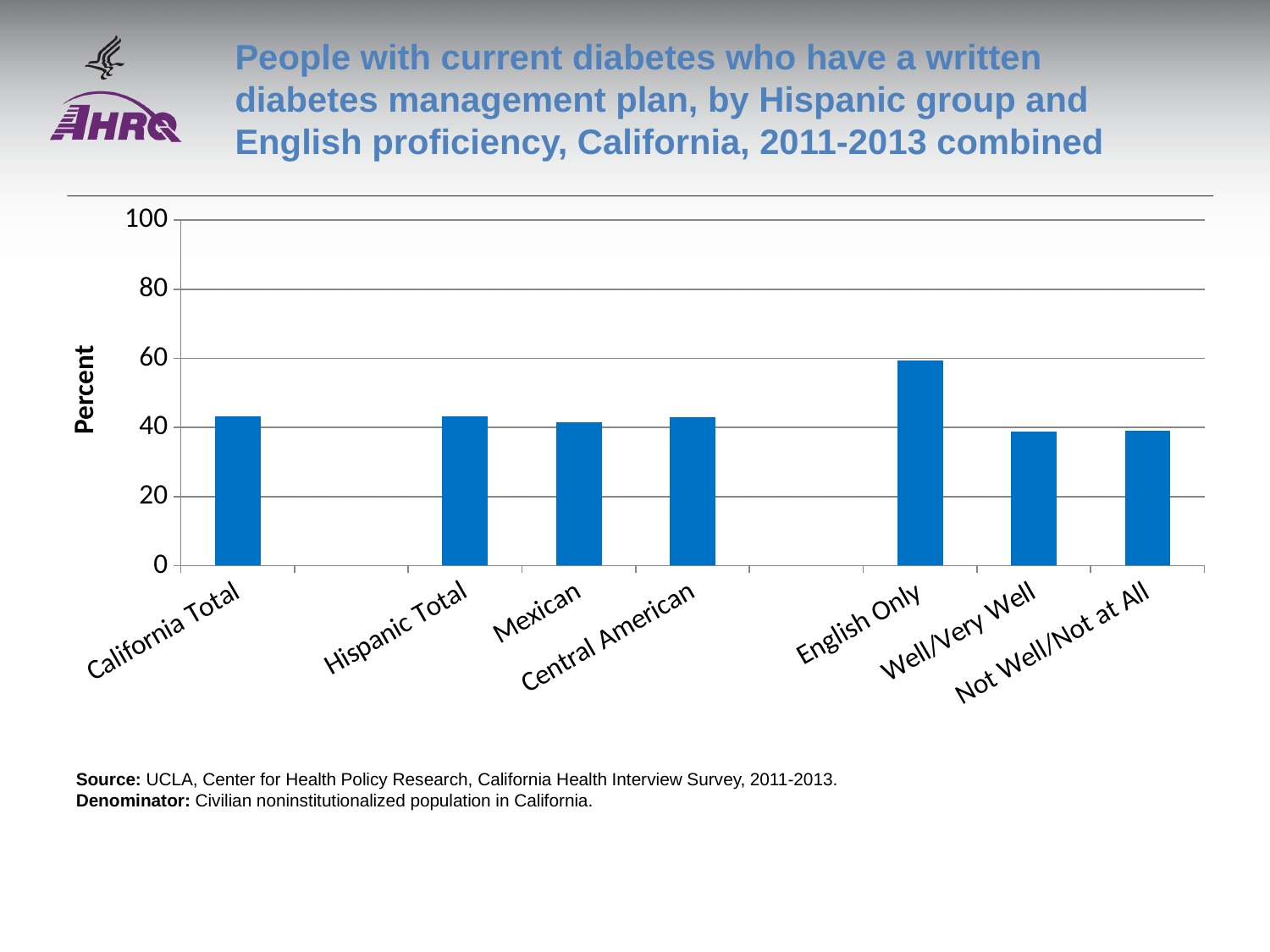
What kind of chart is shown on the slide? bar chart Which category has the highest value in the chart? English Only Which is larger, the value for Well/Very Well or the value for English Only? English Only Is the value for English Only greater or less than 80? less What is the label on the vertical axis of the chart? Percent How many categories (bars) are plotted in the chart? 7 Is the value for Not Well/Not at All greater or less than 60? less What is the highest value shown on the vertical axis of the chart? 100 Which is larger, the value for English Only or the value for Hispanic Total? English Only Is the value for Central American greater or less than 20? greater